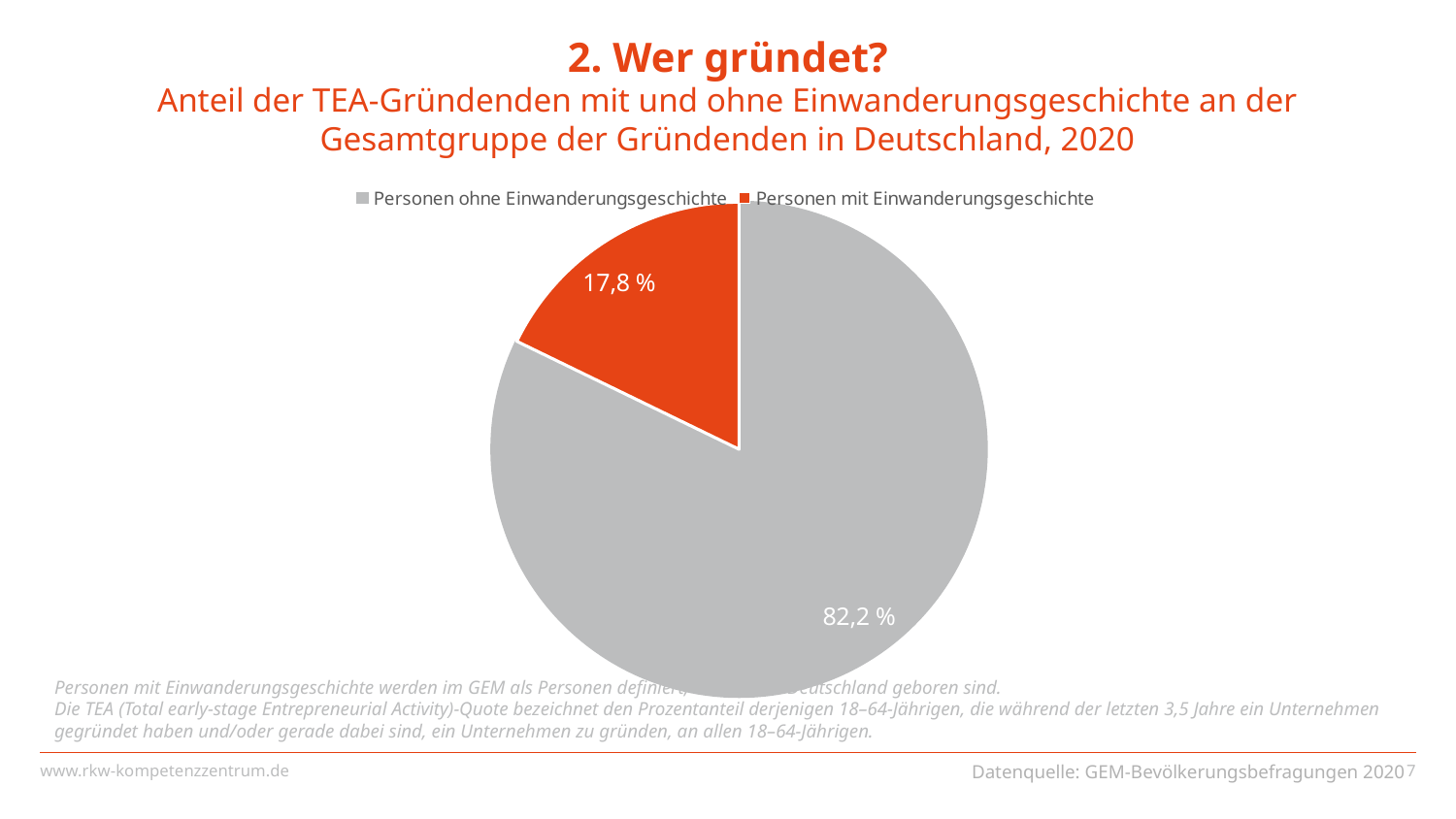
What share of the pie is labelled for Personen mit Einwanderungsgeschichte? 17,8 % Which slice of the pie is the smallest? Personen mit Einwanderungsgeschichte What share of the pie is labelled for Personen ohne Einwanderungsgeschichte? 82,2 % What year does the chart subtitle refer to? 2020 What kind of chart is shown on the slide? pie chart Which is larger: the share for Personen mit Einwanderungsgeschichte or the share for Personen ohne Einwanderungsgeschichte? Personen ohne Einwanderungsgeschichte How many slices does the pie chart have? 2 Which slice of the pie is the largest? Personen ohne Einwanderungsgeschichte How many entries does the legend list? 2 What colour is the slice for Personen mit Einwanderungsgeschichte? orange-red What is the difference in percentage points between the share for Personen ohne Einwanderungsgeschichte and the share for Personen mit Einwanderungsgeschichte? 64,4 % Is the share for Personen mit Einwanderungsgeschichte greater or less than 20 %? less